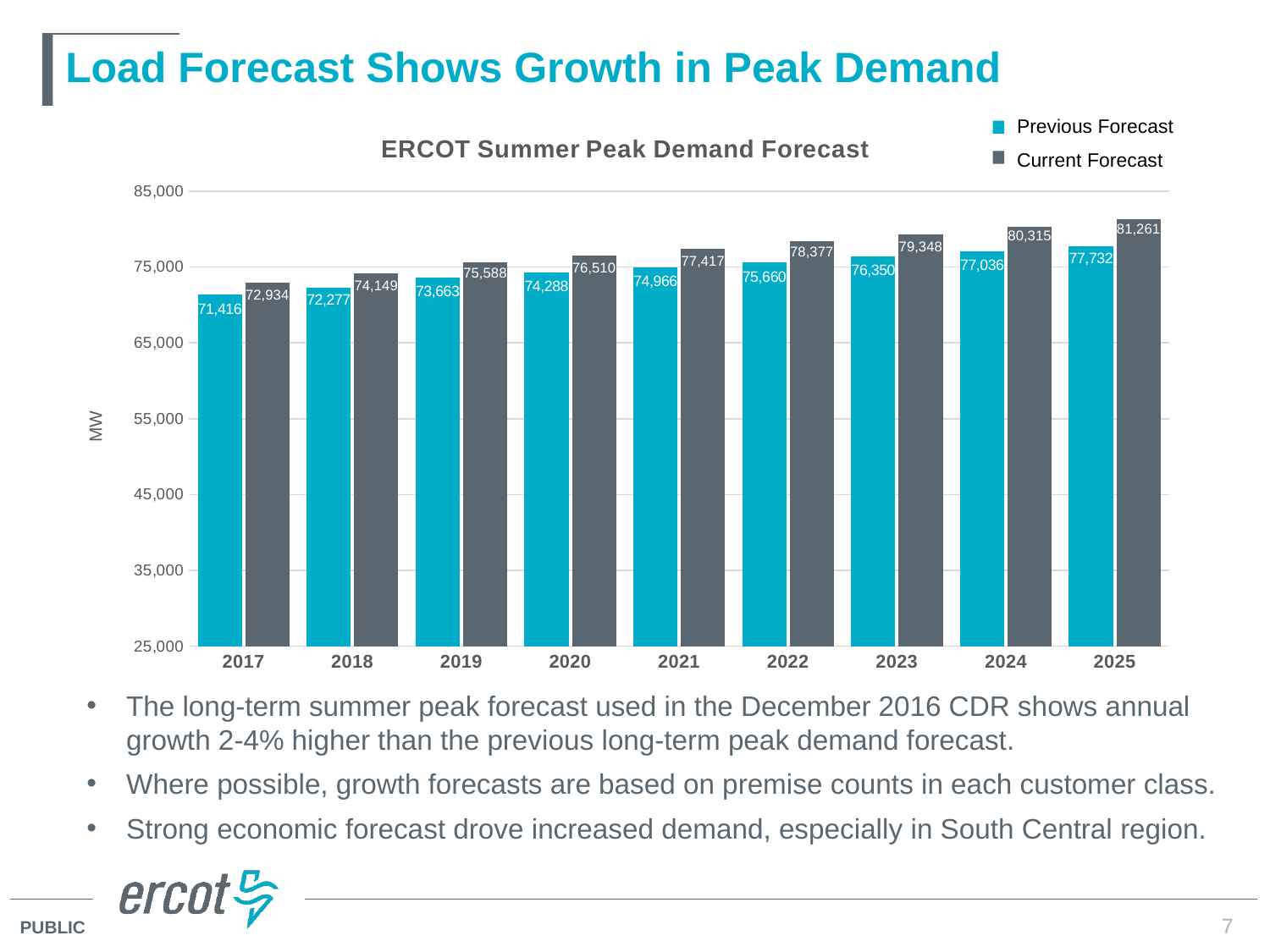
What kind of chart is shown on the slide? Bar chart What is the difference between the Current Forecast and the Previous Forecast for 2017? 1,518 Which year has the highest Current Forecast value? 2025 How many years are shown on the x axis? 9 How many series does the legend list? 2 Which year has the lowest Previous Forecast value? 2017 Do the Current Forecast values rise or fall from 2017 to 2025? Rise What is the Previous Forecast value for 2017? 71,416 Which is larger for 2023, the Previous Forecast or the Current Forecast? Current Forecast What is the difference between the Current Forecast and the Previous Forecast for 2025? 3,529 What is the Current Forecast value for 2025? 81,261 What is the Current Forecast value for 2021? 77,417